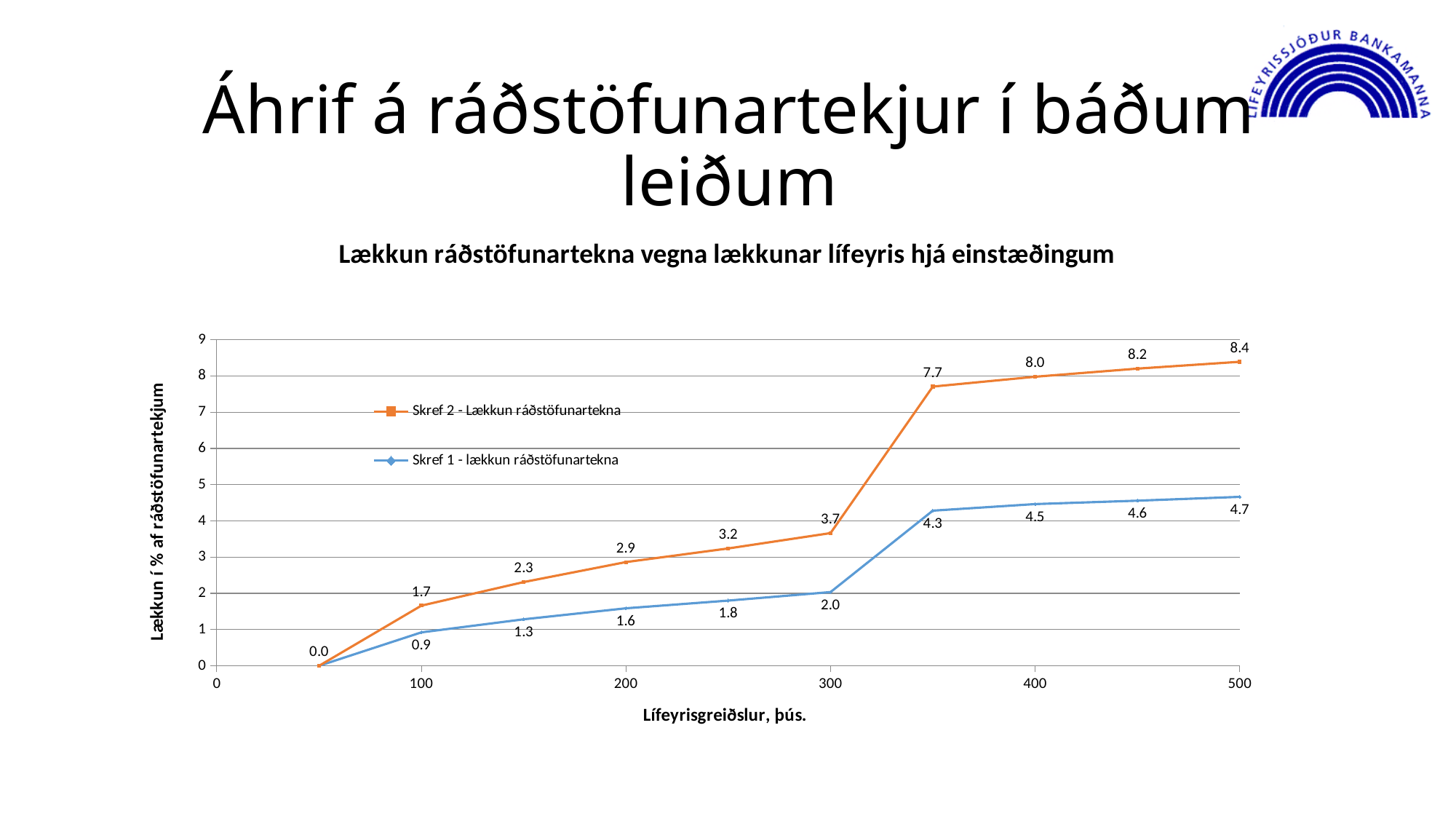
Which series has the larger value at 400 on the x axis, Skref 1 or Skref 2? Skref 2 - Lækkun ráðstöfunartekna What is the value of Skref 1 - lækkun ráðstöfunartekna at 100 on the x axis? 0.9 What is the title of the chart? Lækkun ráðstöfunartekna vegna lækkunar lífeyris hjá einstæðingum What type of chart is shown on the slide? line chart Do the values of the Skref 2 - Lækkun ráðstöfunartekna series rise or fall as the x axis increases? rise What is the value of Skref 1 - lækkun ráðstöfunartekna at 300 on the x axis? 2.0 What is the difference between Skref 2 and Skref 1 at 500 on the x axis? 3.7 What is the value of Skref 2 - Lækkun ráðstöfunartekna at 350 on the x axis? 7.7 What is the value of Skref 2 - Lækkun ráðstöfunartekna at 500 on the x axis? 8.4 How many series does the legend list? 2 What is the difference between Skref 2 and Skref 1 at 350 on the x axis? 3.4 What is the highest value reached by the Skref 1 - lækkun ráðstöfunartekna series? 4.7